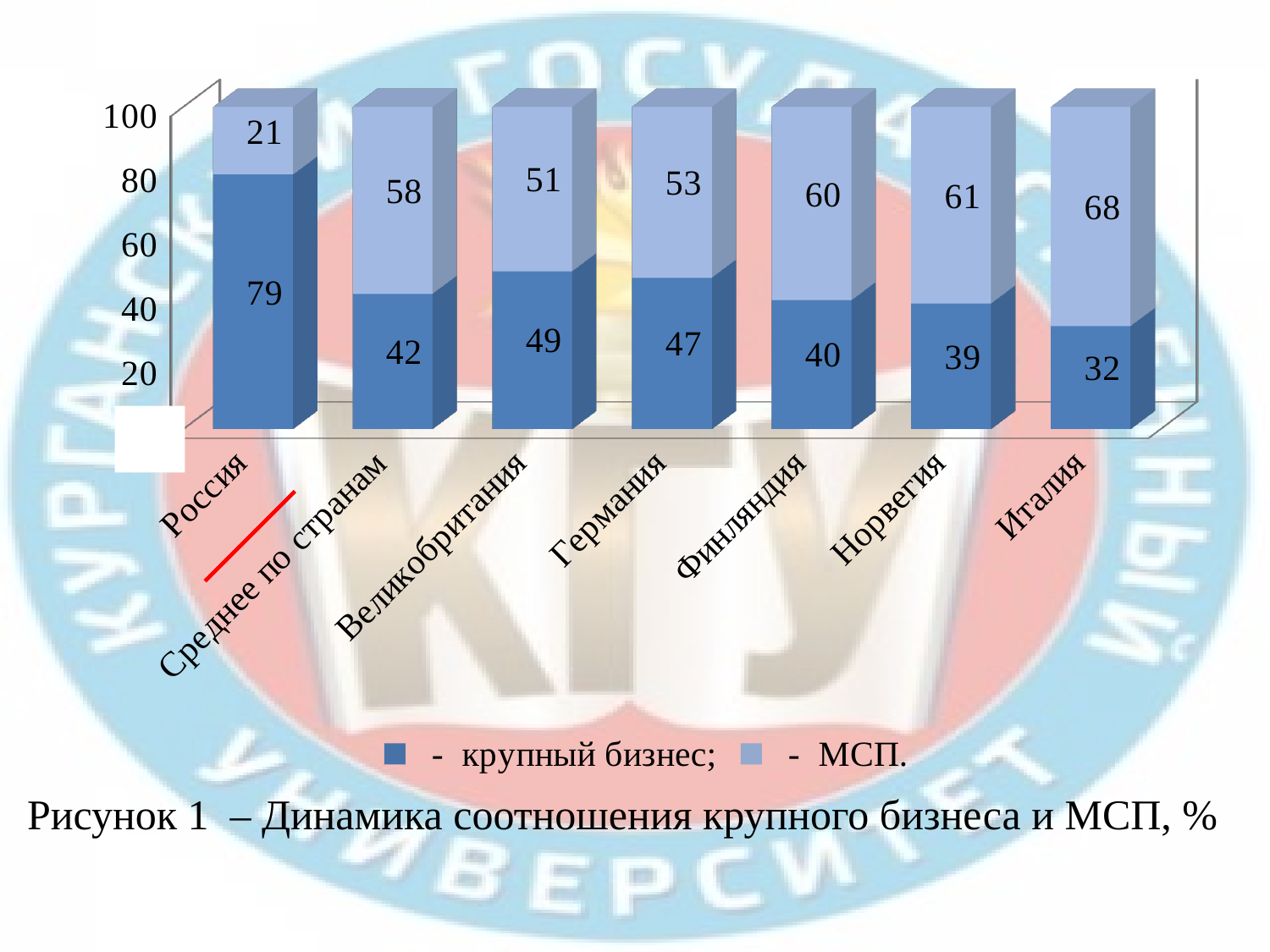
What is the value for МСП in Италия? 68 Which category has the highest value for крупный бизнес? Россия Which is larger, the МСП value for Финляндия or for Норвегия? Норвегия What is the value for крупный бизнес in Россия? 79 What is the value for МСП in Среднее по странам? 58 How many categories are shown on the x axis? 7 What is the total of the stacked bar for Великобритания? 100 What is the value for крупный бизнес in Германия? 47 What kind of chart is shown on the slide? Stacked bar chart What is the difference between the крупный бизнес values for Россия and Италия? 47 Which category has the lowest value for МСП? Россия How many series does the legend list? 2